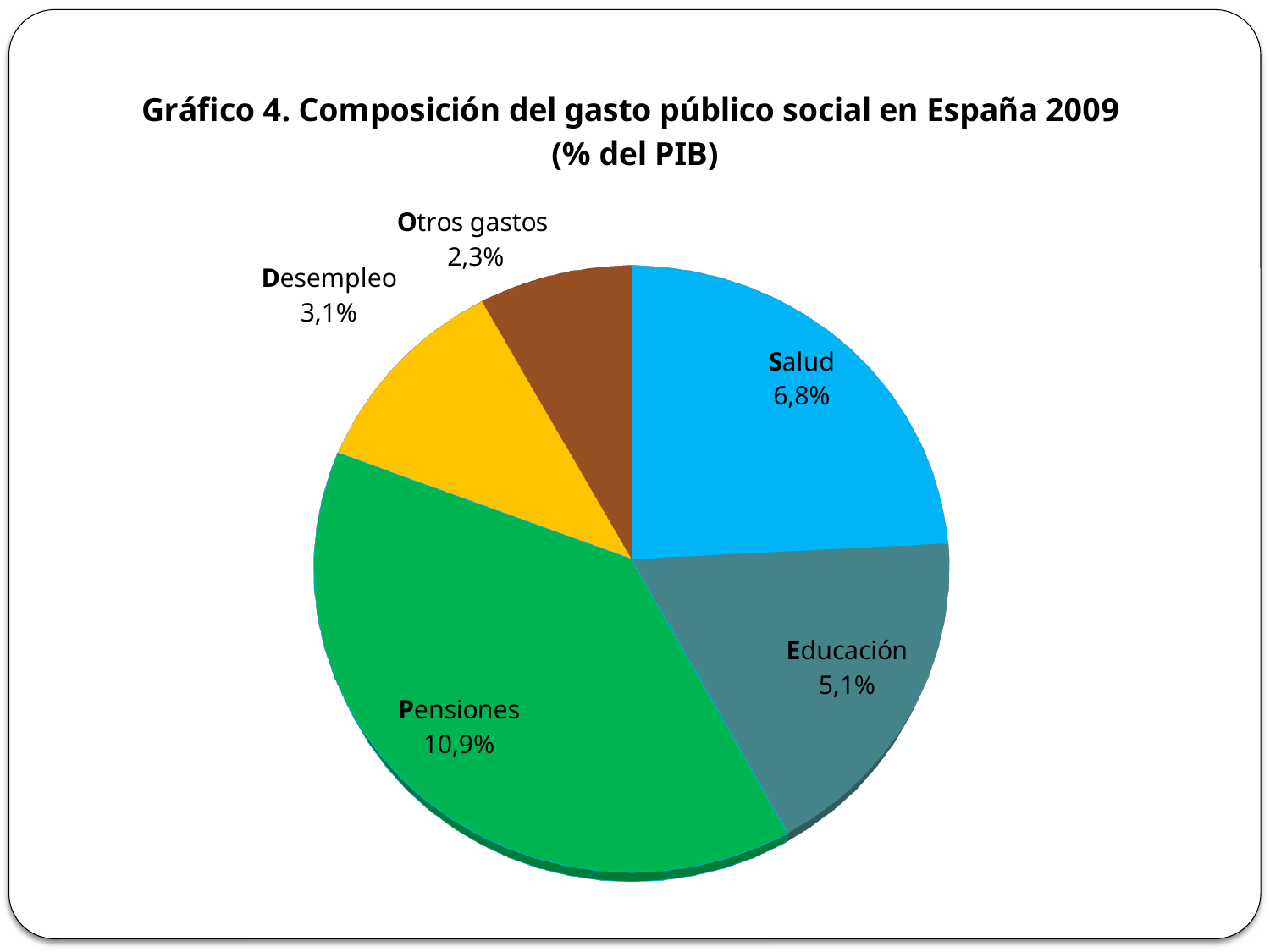
What is the difference between the values for Salud and Educación? 1,7 percentage points What is the difference between the values for Pensiones and Salud? 4,1 percentage points Which category has the largest slice of the pie chart? Pensiones What value is shown for Otros gastos in the pie chart? 2,3% What value is shown for Pensiones in the pie chart? 10,9% What kind of chart is shown on the slide? Pie chart What value is shown for Salud in the pie chart? 6,8% Which category has the smallest slice of the pie chart? Otros gastos What value is shown for Educación in the pie chart? 5,1% What value is shown for Desempleo in the pie chart? 3,1% Which is larger, the value for Desempleo or the value for Otros gastos? Desempleo How many categories are shown in the pie chart? 5